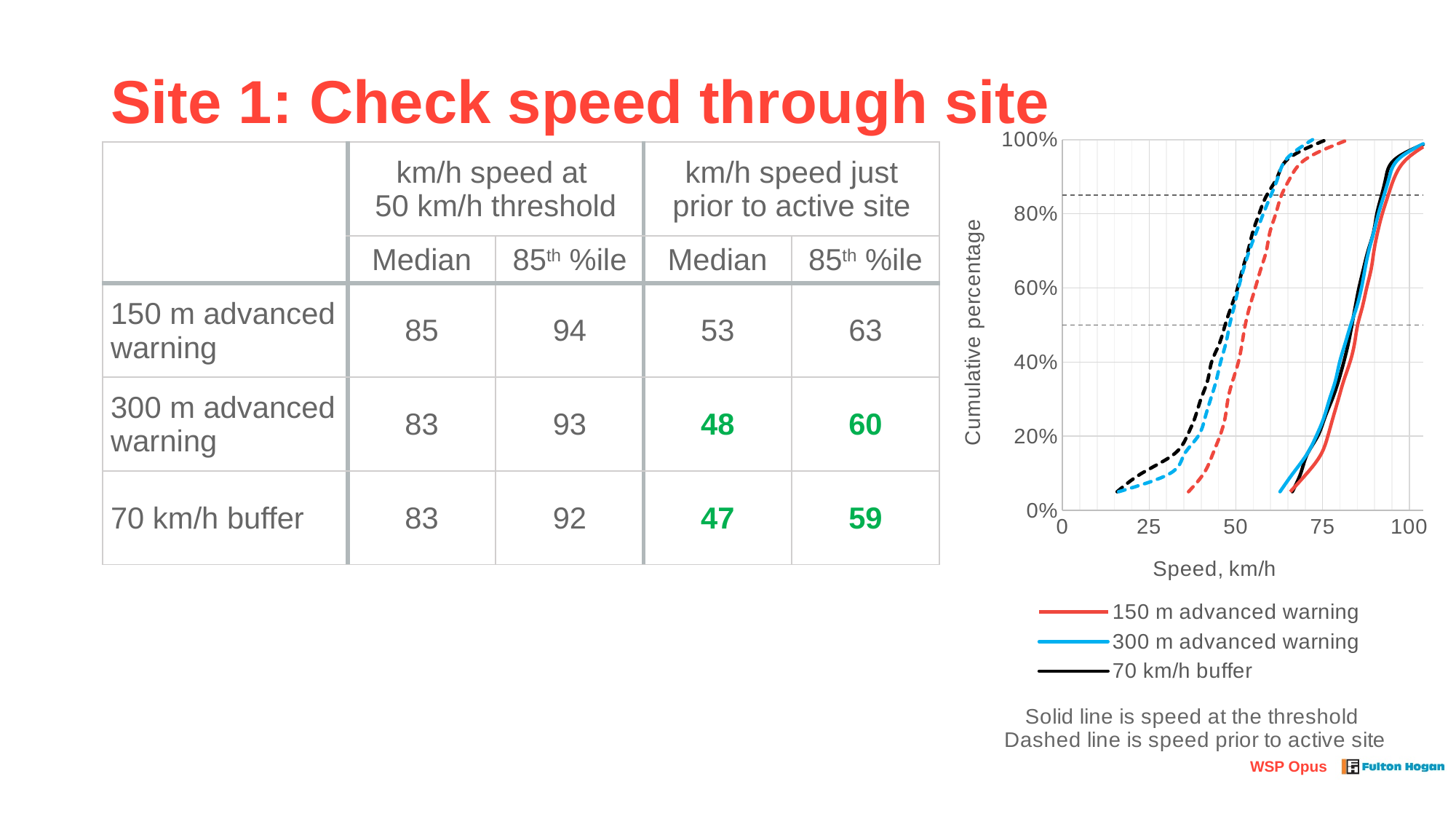
At 50 km/h, which dashed line shows the higher cumulative percentage: the black 70 km/h buffer line or the red 150 m advanced warning line? 70 km/h buffer Do the cumulative percentage lines rise or fall as speed increases along the x axis? rise How many series does the chart legend list? 3 What colour is the 70 km/h buffer line in the chart legend? black What kind of chart is shown on the right of the slide? line chart How many tick labels are shown on the chart's x axis? 5 Is the cumulative percentage of the solid red 150 m advanced warning line at 100 km/h greater or less than 80%? greater Is the cumulative percentage of the dashed black 70 km/h buffer line at 60 km/h greater or less than 60%? greater Is the cumulative percentage of the solid black 70 km/h buffer line at 80 km/h greater or less than 60%? less According to the note under the chart, what do the solid lines represent? speed at the threshold